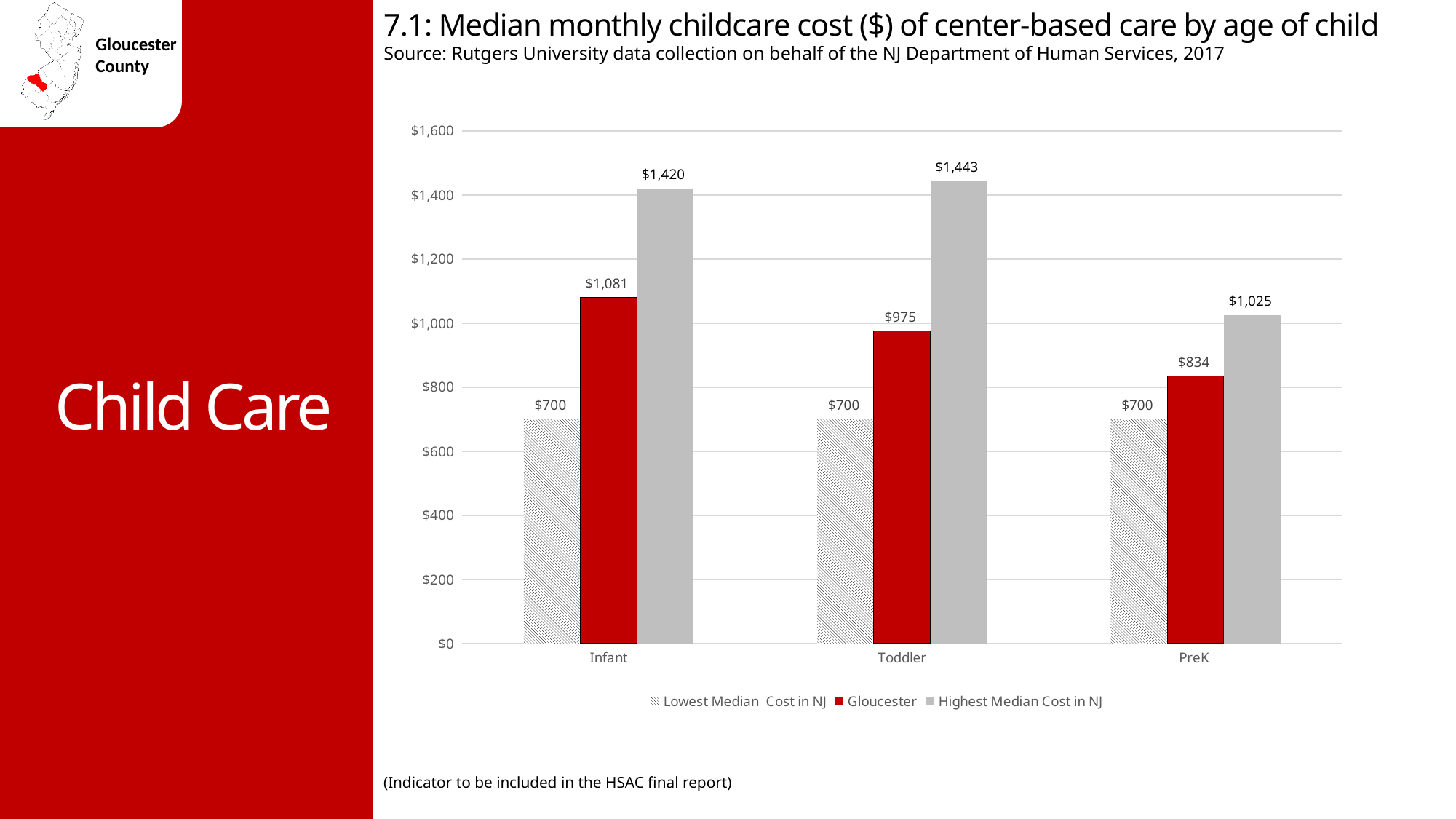
Is the Gloucester cost for PreK care greater or less than $1,000? less How many series does the legend list? 3 What is the Lowest Median Cost in NJ for PreK care? $700 What is the Gloucester median monthly childcare cost for Infant care? $1,081 What is the Highest Median Cost in NJ for Toddler care? $1,443 Which age group has the lowest Highest Median Cost in NJ? PreK What is the difference between the Highest Median Cost in NJ and the Gloucester cost for Toddler care? $468 Do the Gloucester values rise or fall from Infant to PreK? fall How many age groups are shown on the x axis? 3 What kind of chart is shown on the slide? bar chart Which is larger: the Gloucester cost for Toddler care or the Gloucester cost for PreK care? Toddler Which age group has the highest Gloucester median monthly cost? Infant